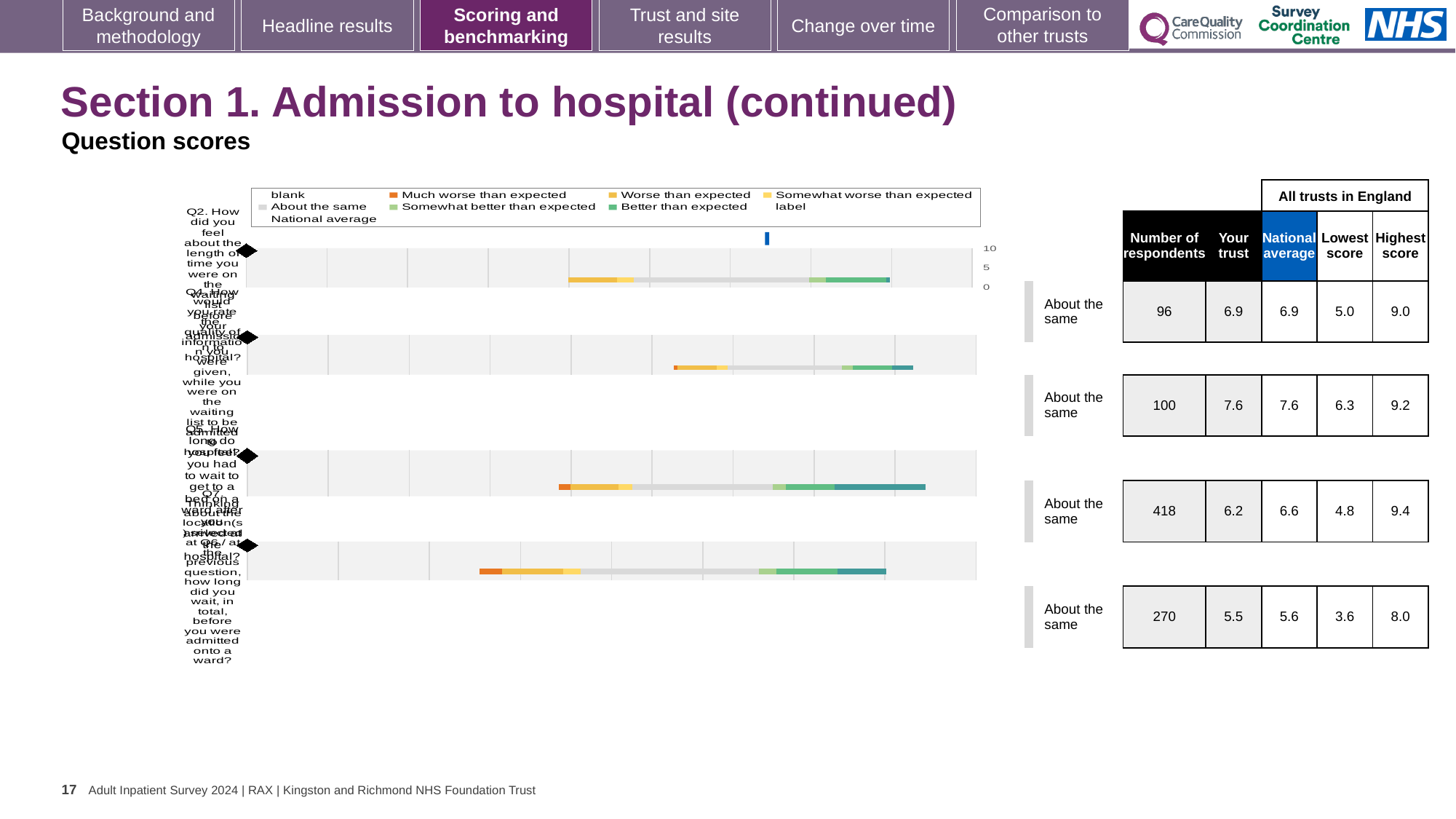
What is the 'Your trust' score for Q2 (how did you feel about the length of time on the waiting list)? 6.9 How many entries does the legend of the question scores chart list? 9 What is the number of respondents for Q5 (how long did you feel you had to wait to get to a bed on a ward)? 418 How many questions (rows) are plotted in the question scores chart? 4 What is the highest score across all trusts in England for Q4? 9.2 Which question has the lowest 'Your trust' score? Q7 What kind of chart is used to show the question scores on this slide? bar chart Is the 'Your trust' score for Q7 greater or less than 5? greater In the question scores chart, which legend entry is shown in dark orange? Much worse than expected What is the difference between the national average and the 'Your trust' score for Q5? 0.4 Which question has the highest 'Your trust' score? Q4 What benchmark category is shown for Q7 in the question scores chart? About the same